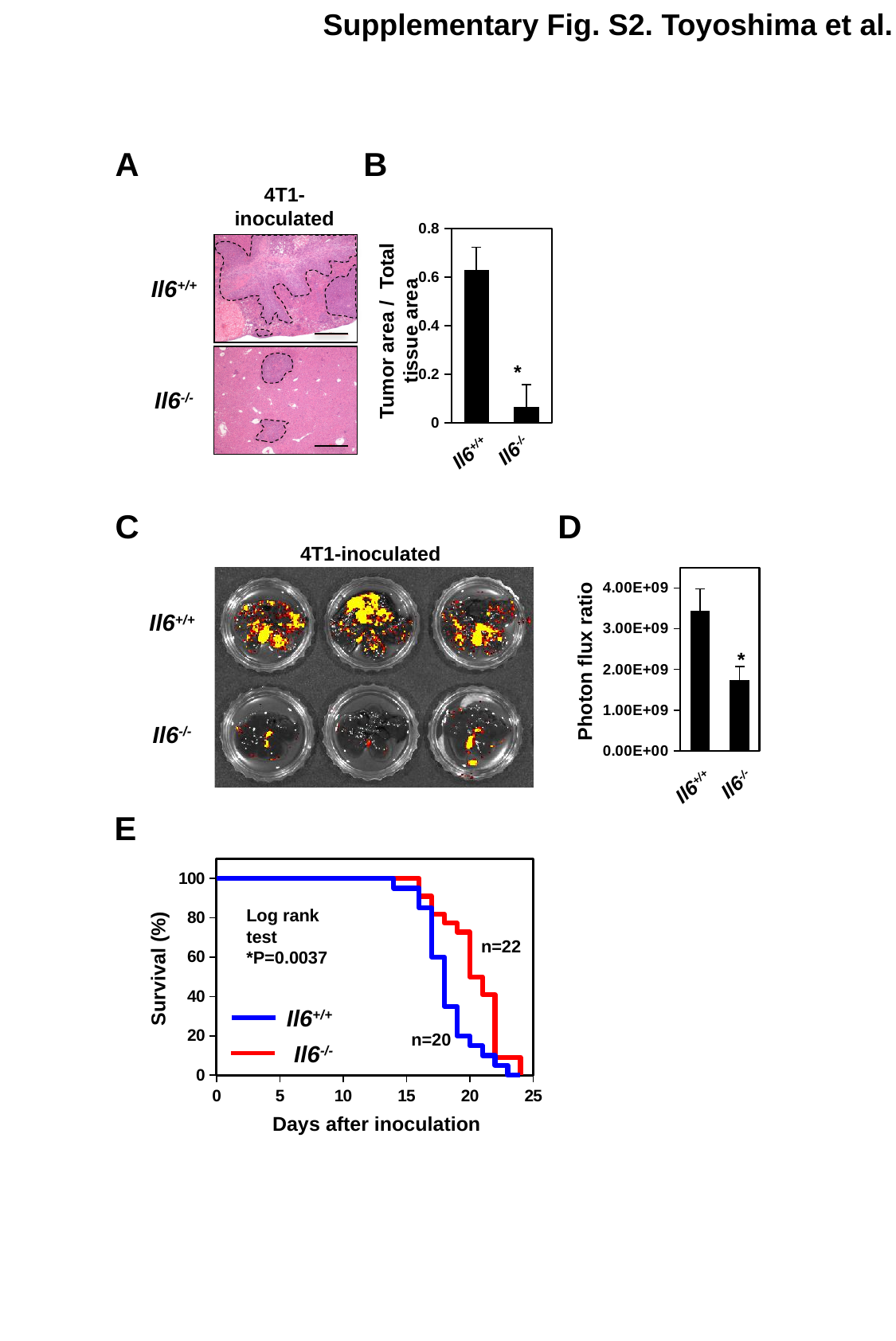
In chart B (Tumor area / Total tissue area), is the value for Il6+/+ greater or less than 0.4? greater How many series does the legend of chart E (Survival) list? 2 In chart B (Tumor area / Total tissue area), which group has the higher value? Il6+/+ In chart E (Survival), which group is plotted with the blue line? Il6+/+ What kind of chart is chart D (Photon flux ratio)? bar chart In chart B (Tumor area / Total tissue area), which group has the lowest value? Il6-/- In chart D (Photon flux ratio), is the value for Il6+/+ greater or less than 3.00E+09? greater In chart B (Tumor area / Total tissue area), is the value for Il6-/- greater or less than 0.2? less In chart E (Survival), do the survival curves rise or fall as days after inoculation increase? fall In chart D (Photon flux ratio), which group has the larger value, Il6+/+ or Il6-/-? Il6+/+ How many categories are shown in chart B (Tumor area / Total tissue area)? 2